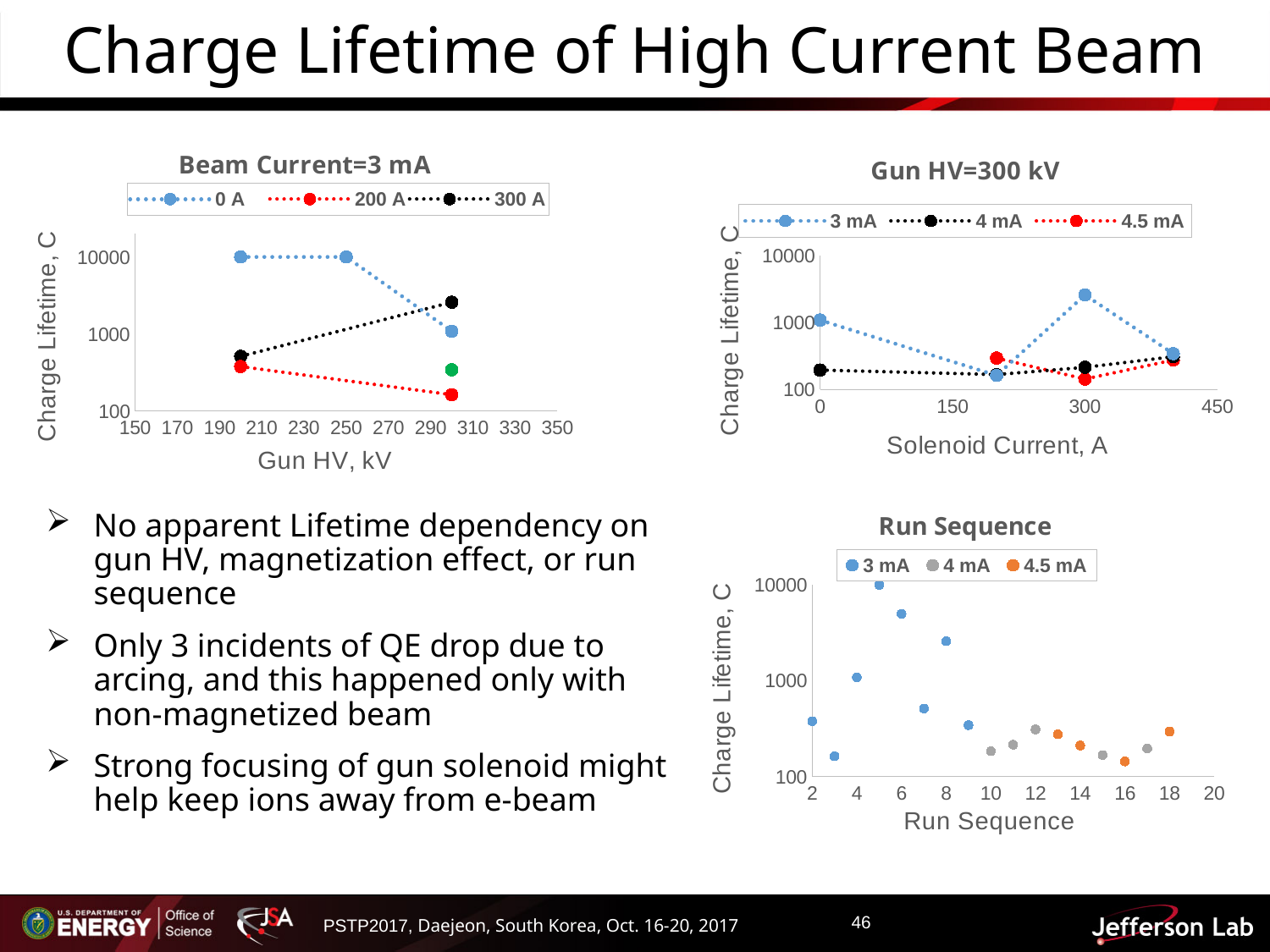
In the "Beam Current=3 mA" chart, does the 200 A series rise or fall from 200 kV to 300 kV? fall How many series does the legend of the "Gun HV=300 kV" chart list? 3 In the "Beam Current=3 mA" chart, is the 0 A value at 200 kV greater or less than 1000? greater In the "Run Sequence" chart, which run sequence number has the highest charge lifetime? 5 In the "Gun HV=300 kV" chart, is the 3 mA value at 300 A solenoid current greater or less than 1000? greater In the "Beam Current=3 mA" chart, at 300 kV, which is larger: the 300 A value or the 200 A value? 300 A In the "Gun HV=300 kV" chart, is the 4 mA value at 0 A solenoid current greater or less than 1000? less What are the legend entries of the "Beam Current=3 mA" chart? 0 A, 200 A, 300 A What kind of chart is the "Beam Current=3 mA" chart? scatter chart What is the x-axis label of the "Gun HV=300 kV" chart? Solenoid Current, A